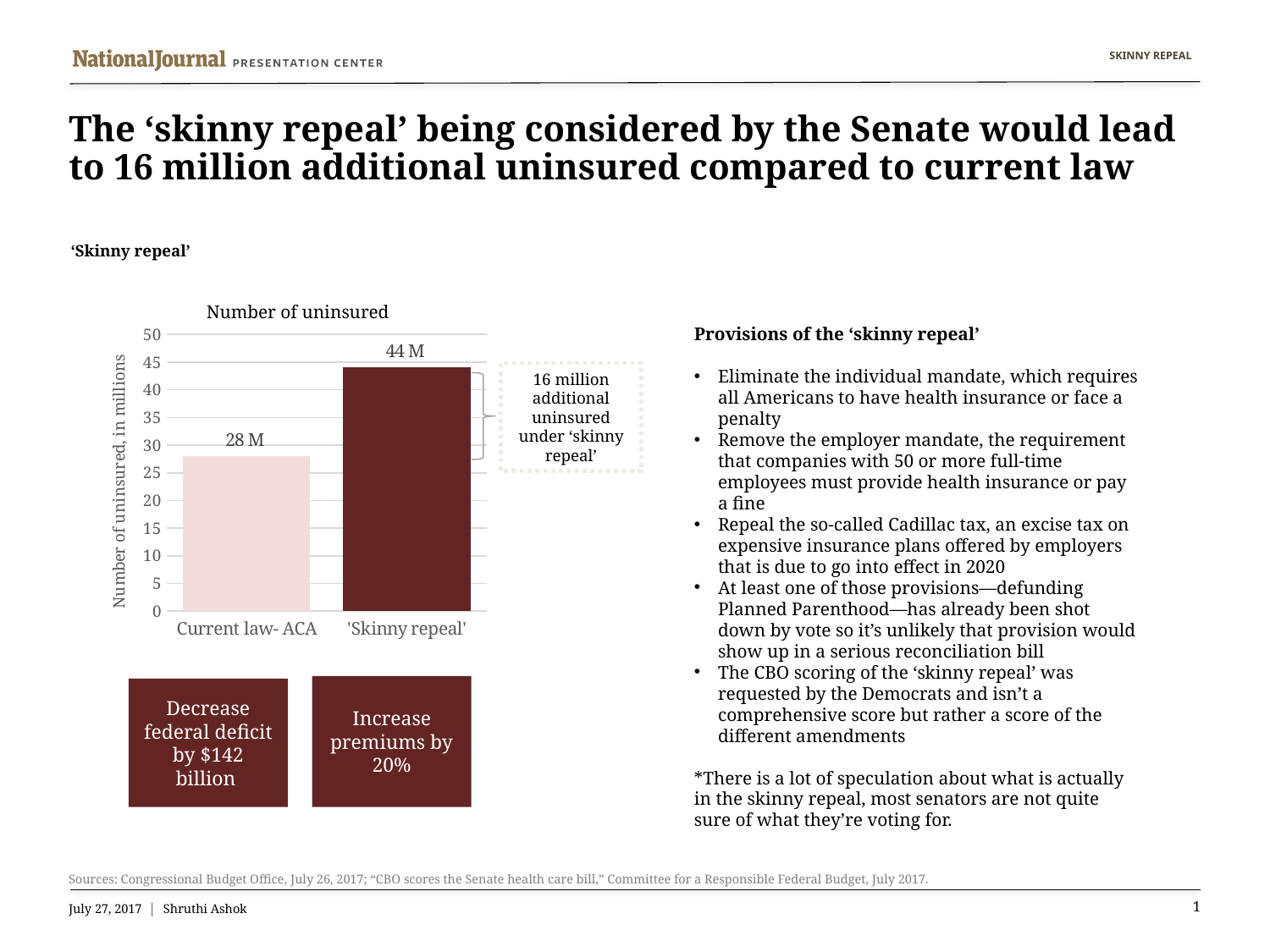
What is the label of the y axis of the chart? Number of uninsured, in millions What is the difference in millions of uninsured between the 'Skinny repeal' and current law? 16 M Which category has the higher number of uninsured? 'Skinny repeal' What type of chart is shown on the slide? Bar chart How many categories are shown on the chart? 2 Is the value for current law (ACA) greater or less than 30? less What is the number of uninsured under current law (ACA)? 28 M What is the number of uninsured under the 'Skinny repeal'? 44 M Is the number of uninsured larger under current law or under the 'Skinny repeal'? 'Skinny repeal' What is the title of the chart? Number of uninsured Which category has the lower number of uninsured? Current law- ACA Is the value for the 'Skinny repeal' greater or less than 40? greater